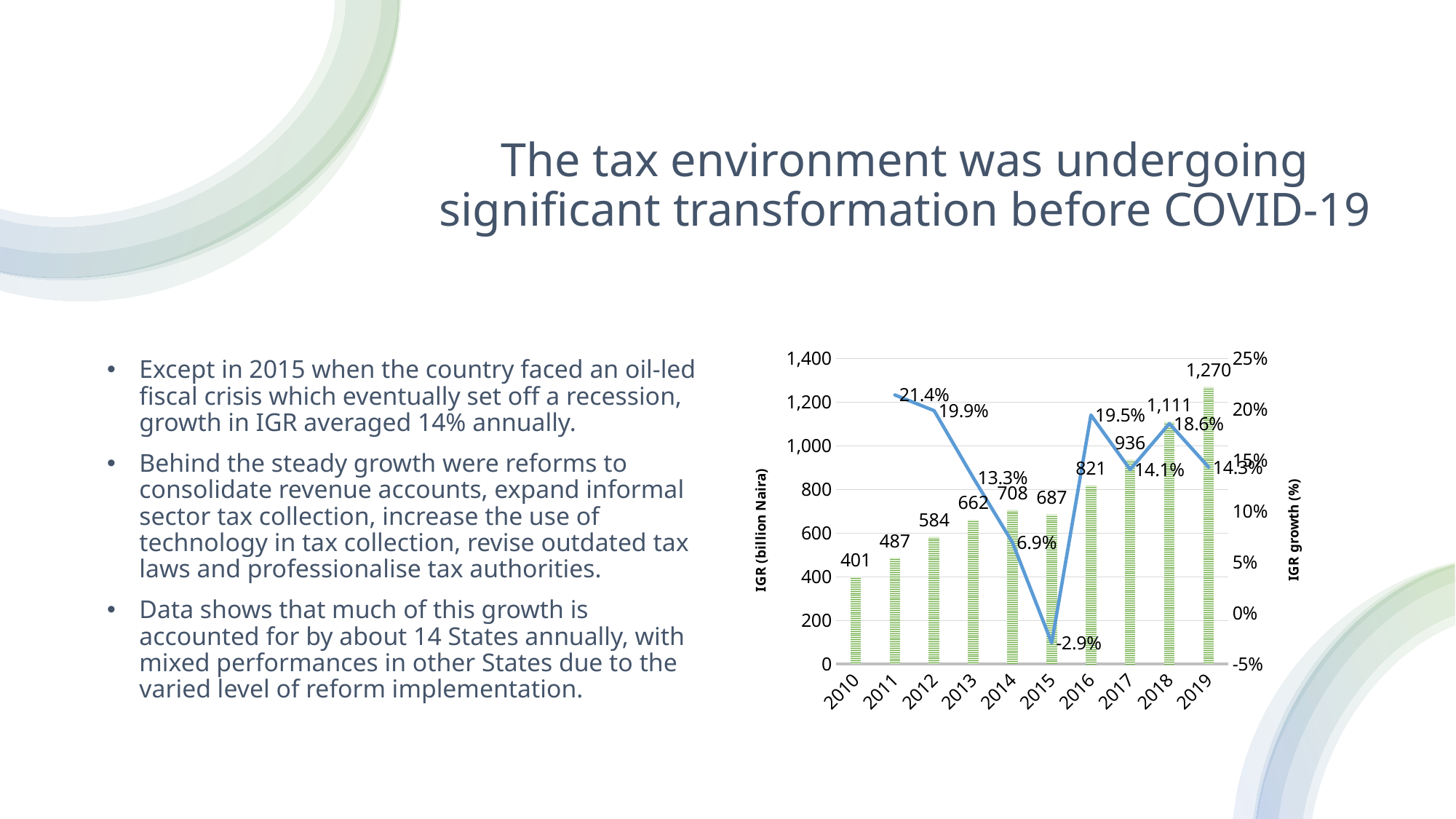
What kind of chart is shown on the slide? Combined bar and line chart What is the IGR growth (%) value for 2015? -2.9% Is the IGR (billion Naira) value for 2017 greater or less than 800? greater Which year has the lowest IGR growth (%) on the line? 2015 What is the IGR (billion Naira) value for 2019? 1,270 How many years are shown on the x axis of the chart? 10 What is the title of the left vertical axis of the chart? IGR (billion Naira) Which is larger, the IGR (billion Naira) value for 2014 or for 2015? 2014 What is the difference between the IGR (billion Naira) values for 2019 and 2018? 159 What is the IGR growth (%) value for 2011? 21.4% Which year has the highest IGR (billion Naira) bar? 2019 What is the IGR (billion Naira) value for 2010? 401